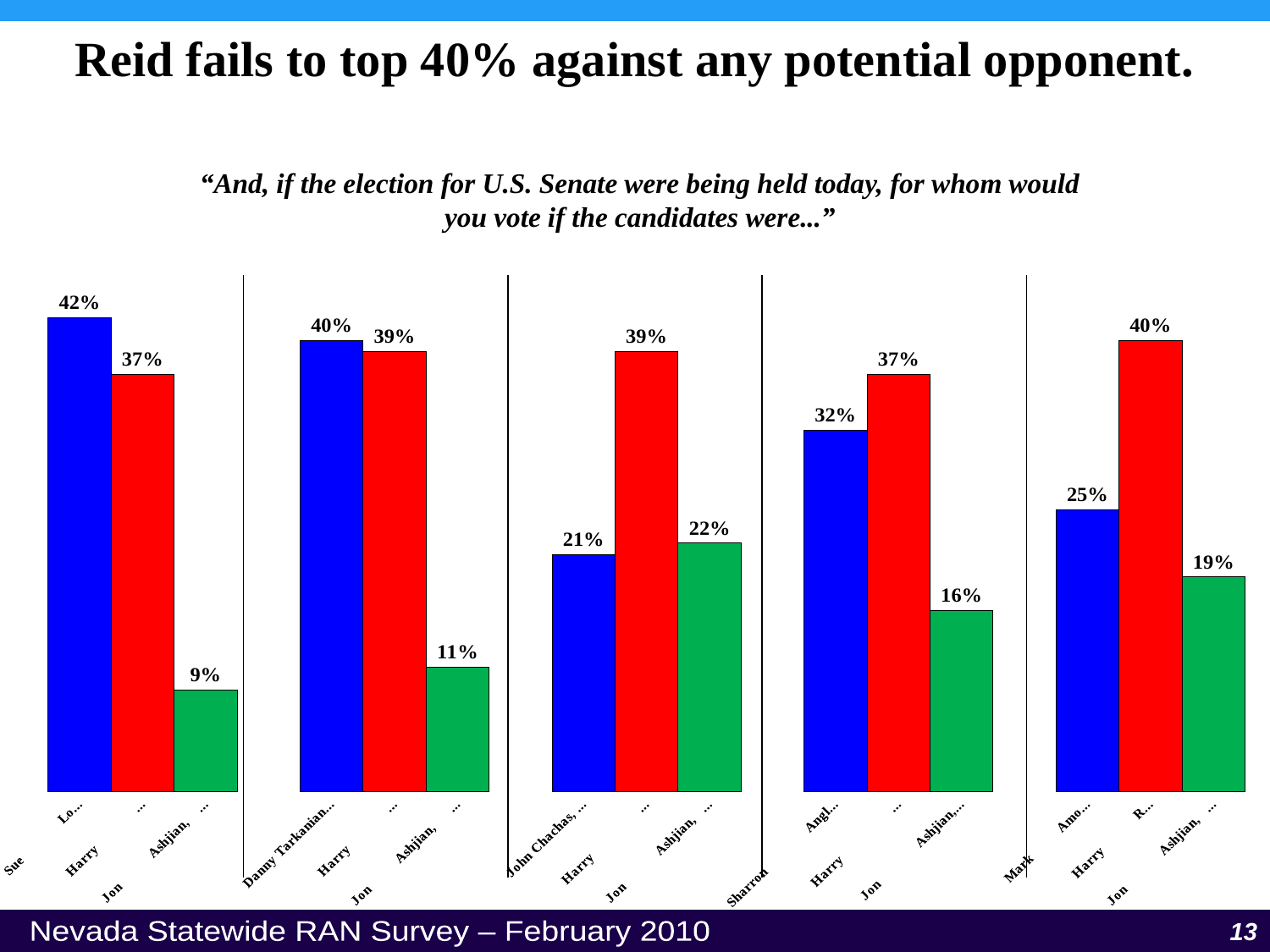
How many bars are shown in each chart panel? 3 In the leftmost chart panel, what value is shown for the blue bar (Sue Lo...)? 42% What is the title of the slide above the charts? Reid fails to top 40% against any potential opponent. In the second chart panel from the left, what is the difference between the blue bar (40%) and the red bar (39%)? 1 percentage point In the third chart panel from the left, which is larger: the blue bar or the green bar? The green bar (22% vs 21%) In the second chart panel from the left (Danny Tarkanian), what value is shown for the red bar labelled Harry? 39% What type of chart is used on this slide? Bar chart How many separate chart panels are shown on the slide? 5 In the rightmost chart panel (Mark Amo...), which bar has the lowest value? The green bar (Jon Ashjian), 19% In the fourth chart panel from the left (Sharron Angl...), which bar has the highest value? The red bar (Harry), 37% In the third chart panel from the left (John Chachas), what value is shown for the green bar labelled Jon Ashjian? 22% In the leftmost chart panel, what is the difference between the blue bar (42%) and the red bar (37%)? 5 percentage points